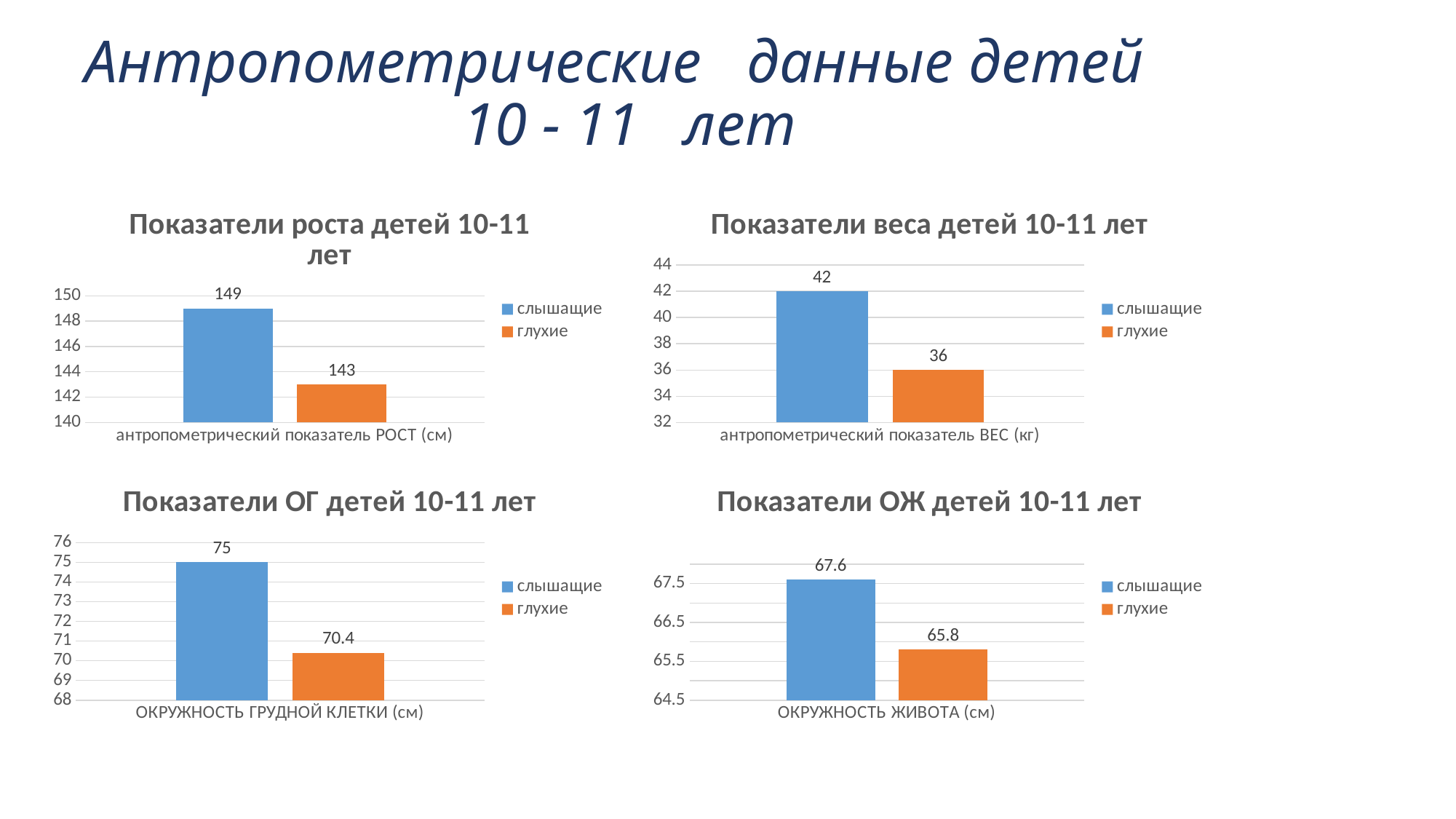
In the chart titled 'Показатели ОЖ детей 10-11 лет', what is the value for глухие? 65.8 In the chart titled 'Показатели веса детей 10-11 лет', what is the difference between the values for слышащие and глухие? 6 In the chart titled 'Показатели веса детей 10-11 лет', which series has the higher value? слышащие How many series does the legend list in the chart titled 'Показатели ОЖ детей 10-11 лет'? 2 What kind of chart is the chart titled 'Показатели ОГ детей 10-11 лет'? bar chart In the chart titled 'Показатели ОЖ детей 10-11 лет', what is the value for слышащие? 67.6 In the chart titled 'Показатели роста детей 10-11 лет', what is the difference between the values for слышащие and глухие? 6 In the chart titled 'Показатели роста детей 10-11 лет', what is the value for глухие? 143 In the chart titled 'Показатели веса детей 10-11 лет', what is the value for глухие? 36 In the chart titled 'Показатели ОГ детей 10-11 лет', which series has the lowest value? глухие In the chart titled 'Показатели ОГ детей 10-11 лет', what is the value for глухие? 70.4 In the chart titled 'Показатели роста детей 10-11 лет', what is the value for слышащие? 149